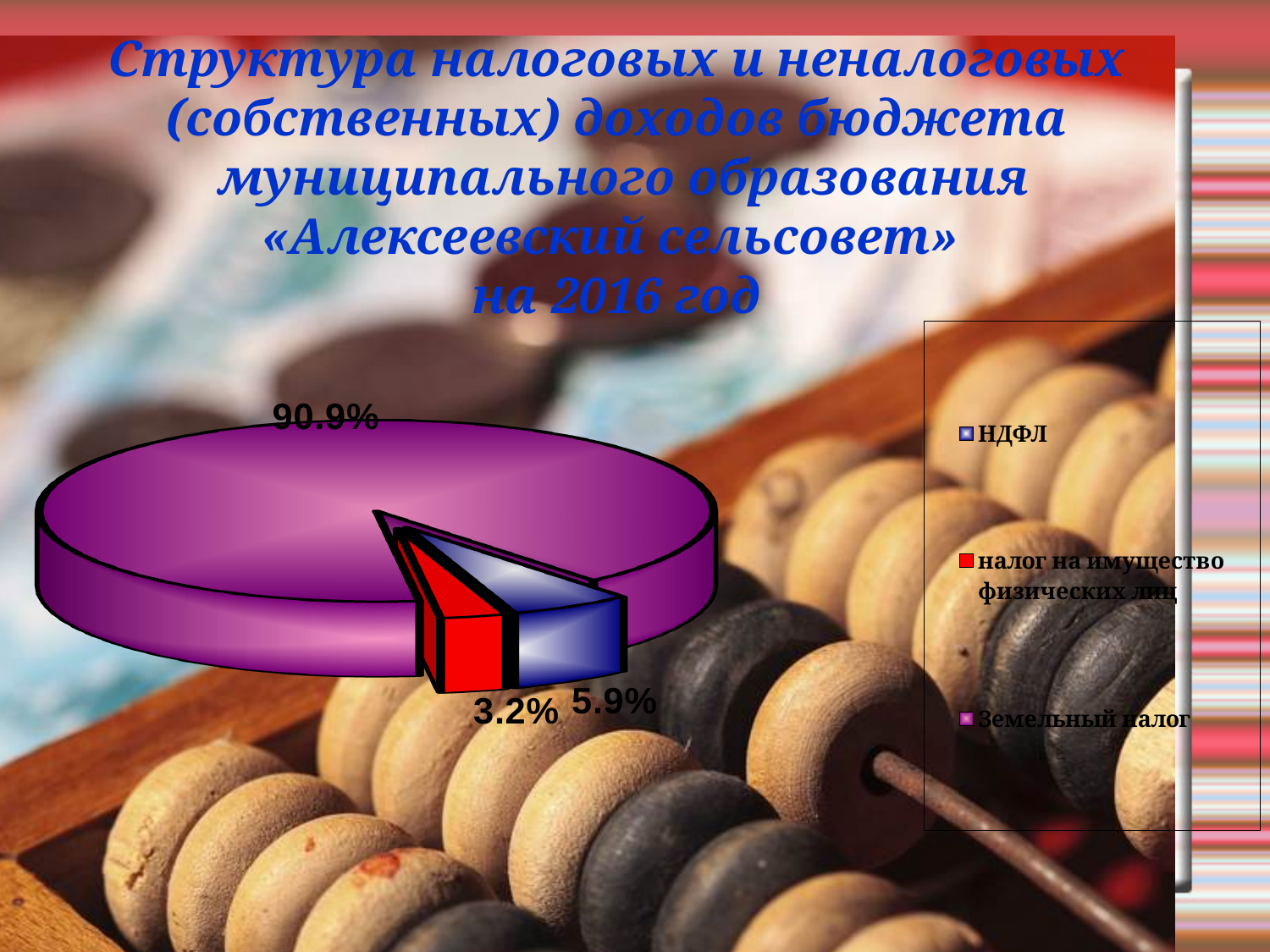
Which category has the largest slice of the pie? Земельный налог How many entries does the legend list? 3 What kind of chart is shown on the slide? pie chart Which is larger, the slice for НДФЛ or the slice for налог на имущество физических лиц? НДФЛ What is the difference between the share of Земельный налог and the share of НДФЛ? 85.0% What is the difference between the share of НДФЛ and the share of налог на имущество физических лиц? 2.7% What share of the pie does Земельный налог have? 90.9% What is the value shown for налог на имущество физических лиц? 3.2% How many slices does the pie chart have? 3 What is the value shown for НДФЛ? 5.9% Which category has the smallest slice of the pie? налог на имущество физических лиц What colour is the slice for Земельный налог? purple